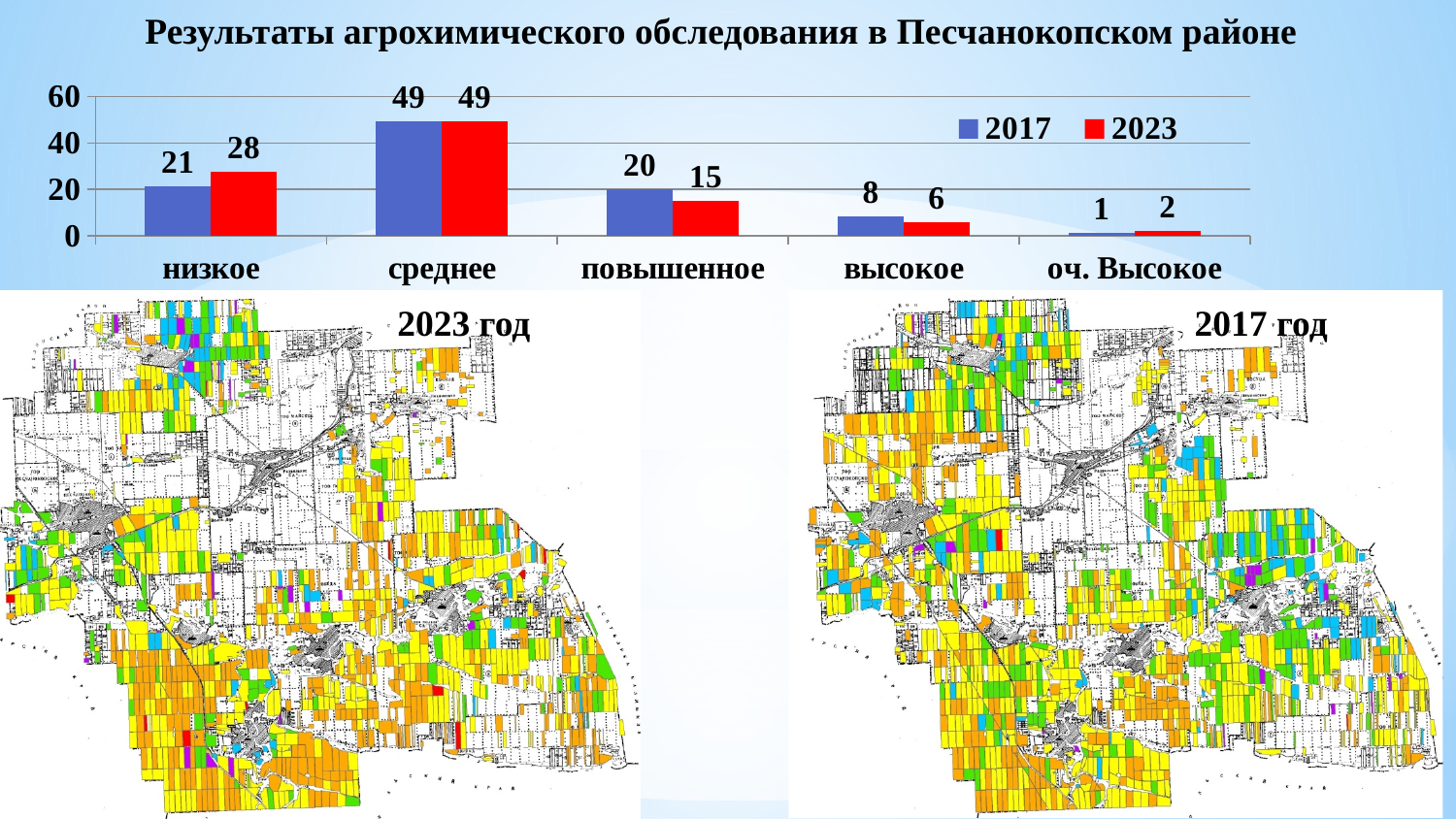
What is the value for 2017 in the 'низкое' category? 21 Is the 2017 value for 'среднее' greater or less than 40? greater What is the value for 2023 in the 'повышенное' category? 15 Which category has the lowest value for 2017? оч. Высокое What colour represents the 2023 series in the chart? red How many categories are shown on the x axis of the chart? 5 Which category has the highest value for 2023? среднее How many series does the legend list? 2 What is the value for 2023 in the 'оч. Высокое' category? 2 What kind of chart is shown on the slide? bar chart What is the difference between the 2023 and 2017 values in the 'низкое' category? 7 Which is larger in the 'высокое' category, the 2017 value or the 2023 value? 2017